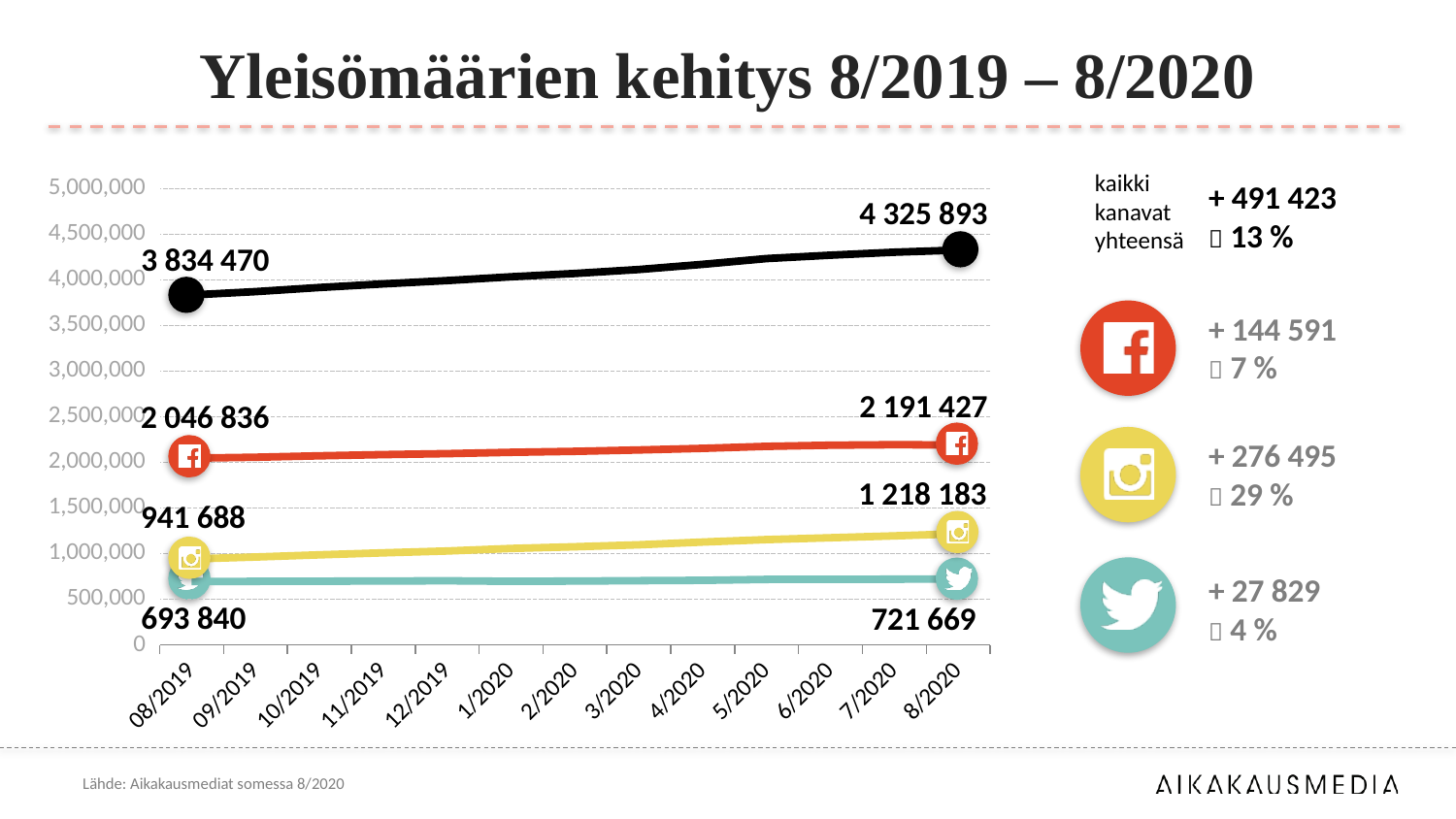
What is the value of the Twitter (teal) line at 08/2019? 693 840 What is the value of the Instagram (yellow) line at 8/2020? 1 218 183 What is the value of the Facebook (red) line at 08/2019? 2 046 836 Does the Instagram (yellow) line rise or fall from 08/2019 to 8/2020? Rise Which line has the lowest value at 8/2020? Twitter (teal) How many months are shown on the x axis? 13 What is the value of the black (all channels total) line at 8/2020? 4 325 893 What is the title of the chart on the slide? Yleisömäärien kehitys 8/2019 – 8/2020 Which is larger: the Facebook value at 08/2019 or the Instagram value at 8/2020? Facebook at 08/2019 By how much did the Instagram (yellow) line increase from 08/2019 to 8/2020? 276 495 Which line has the highest value at 8/2020? The black line (all channels total) What kind of chart is shown on the slide? Line chart